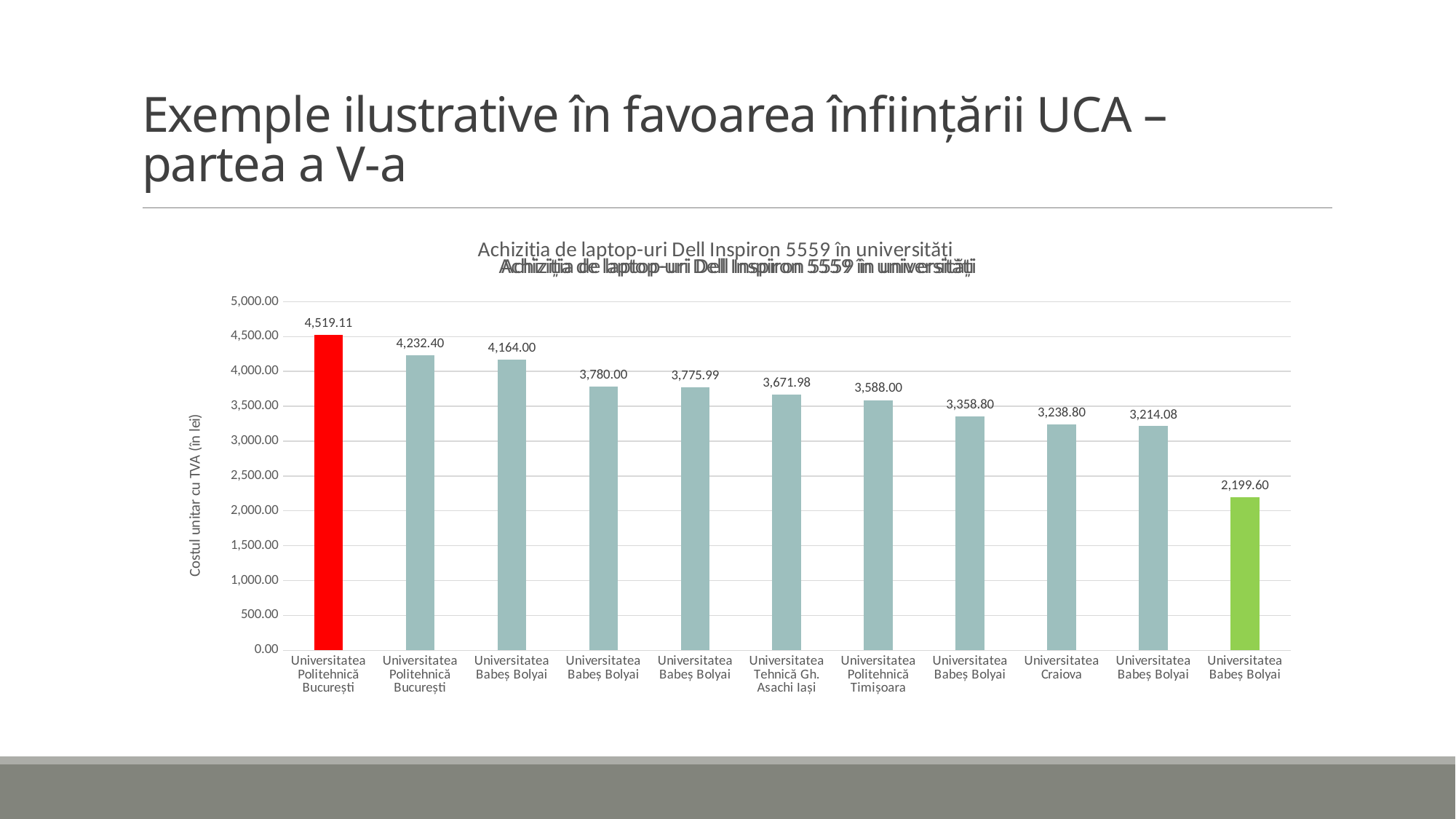
What is the value for Universitatea Tehnică Gh. Asachi Iași? 3,671.98 What is the value for Universitatea Politehnică Timișoara? 3,588.00 What is the label of the vertical axis? Costul unitar cu TVA (în lei) What is the difference between the highest value (4,519.11) and the lowest value (2,199.60)? 2,319.51 What is the value for Universitatea Craiova? 3,238.80 Which is larger, the value for Universitatea Politehnică Timișoara or the value for Universitatea Craiova? Universitatea Politehnică Timișoara What is the value of the red bar (the first bar, Universitatea Politehnică București)? 4,519.11 Which bar has the highest value? the first bar, Universitatea Politehnică București (4,519.11) Which bar has the lowest value? the last bar, Universitatea Babeș Bolyai (2,199.60) What is the value of the green bar (the last bar, Universitatea Babeș Bolyai)? 2,199.60 What kind of chart is shown on the slide? bar chart How many bars are plotted in the chart? 11